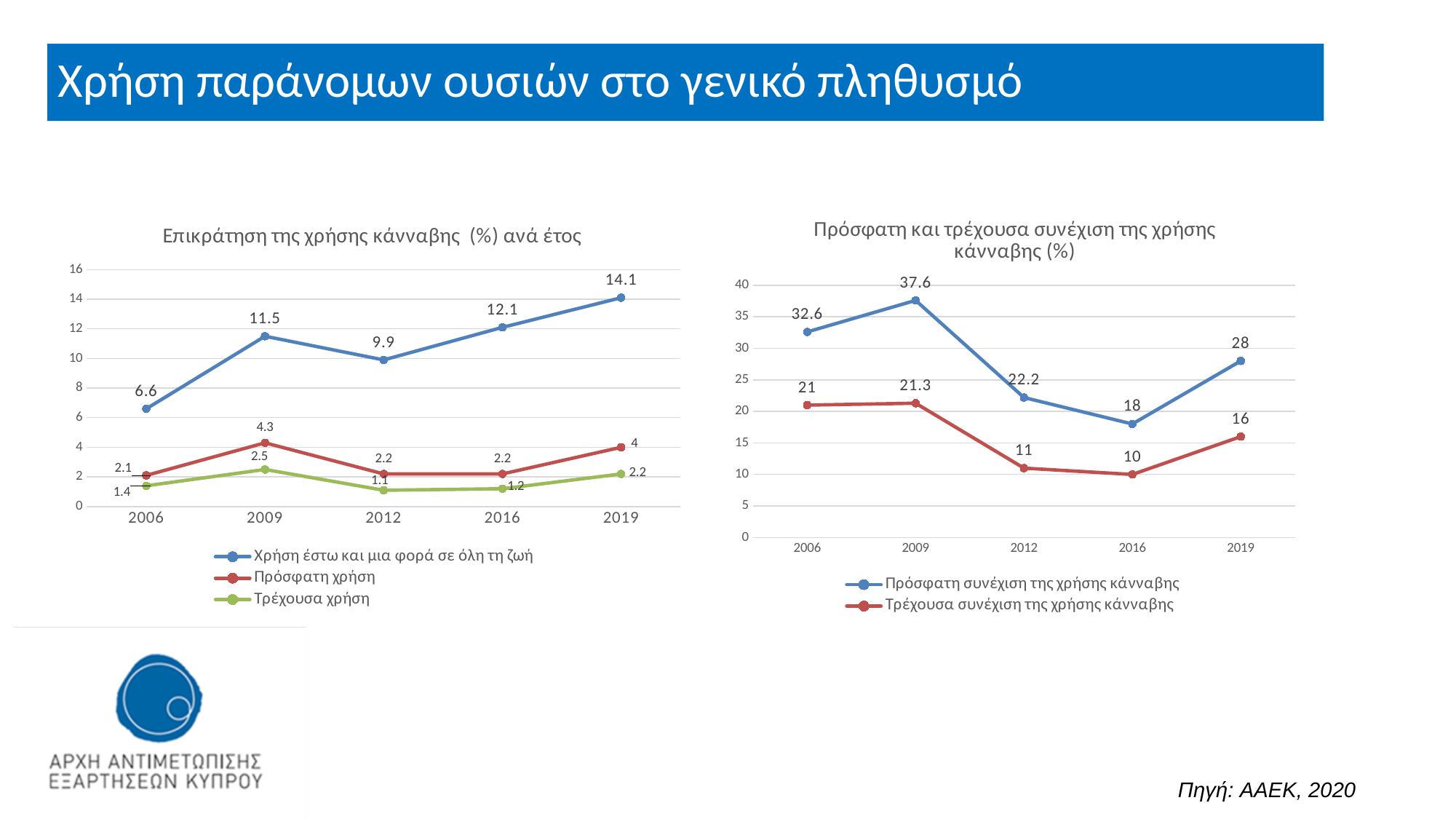
In the right chart (Πρόσφατη και τρέχουσα συνέχιση της χρήσης κάνναβης (%)), what is the value for Τρέχουσα συνέχιση της χρήσης κάνναβης in 2016? 10 In the right chart (Πρόσφατη και τρέχουσα συνέχιση της χρήσης κάνναβης (%)), in which year is Πρόσφατη συνέχιση της χρήσης κάνναβης highest? 2009 In the right chart (Πρόσφατη και τρέχουσα συνέχιση της χρήσης κάνναβης (%)), what is the difference between Πρόσφατη συνέχιση and Τρέχουσα συνέχιση in 2019? 12 In the left chart (Επικράτηση της χρήσης κάνναβης (%) ανά έτος), how many series does the legend list? 3 In the right chart (Πρόσφατη και τρέχουσα συνέχιση της χρήσης κάνναβης (%)), what is the value for Πρόσφατη συνέχιση της χρήσης κάνναβης in 2009? 37.6 In the left chart (Επικράτηση της χρήσης κάνναβης (%) ανά έτος), what is the value for Πρόσφατη χρήση in 2009? 4.3 What type of chart is the right chart (Πρόσφατη και τρέχουσα συνέχιση της χρήσης κάνναβης (%))? Line chart In the left chart (Επικράτηση της χρήσης κάνναβης (%) ανά έτος), what is the difference between Χρήση έστω και μια φορά σε όλη τη ζωή in 2019 and in 2006? 7.5 In the left chart (Επικράτηση της χρήσης κάνναβης (%) ανά έτος), in which year is Χρήση έστω και μια φορά σε όλη τη ζωή lowest? 2006 In the left chart (Επικράτηση της χρήσης κάνναβης (%) ανά έτος), what is the value for Τρέχουσα χρήση in 2012? 1.1 In the right chart (Πρόσφατη και τρέχουσα συνέχιση της χρήσης κάνναβης (%)), how many years are shown on the x axis? 5 In the left chart (Επικράτηση της χρήσης κάνναβης (%) ανά έτος), what is the value for Χρήση έστω και μια φορά σε όλη τη ζωή in 2019? 14.1